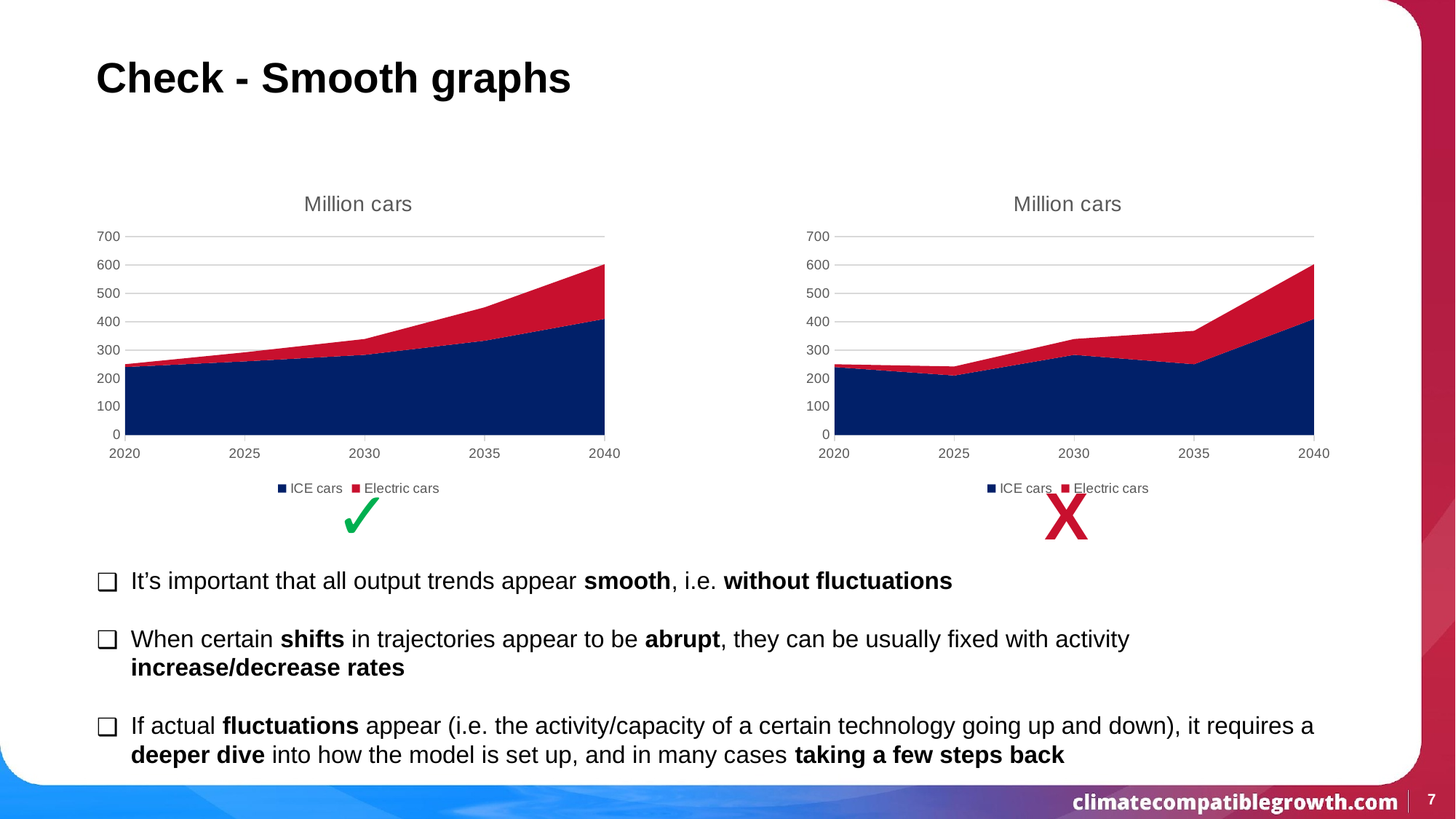
How many series does the legend of the left chart list? 2 What kind of chart is the left chart titled 'Million cars'? Area chart In the left chart, is the total value for 2040 greater or less than 500? greater In the right chart, is the value for ICE cars larger in 2030 or in 2035? 2030 In the right chart, is the value for ICE cars in 2025 greater or less than 300? less In the left chart, does the total number of cars rise or fall from 2020 to 2040? Rise In the right chart, which year has the lowest value for ICE cars? 2025 In the left chart, which year has the highest total number of cars? 2040 In the left chart, is the value for ICE cars in 2020 greater or less than 300? less What are the two series named in the legend of the right chart? ICE cars and Electric cars How many years are labelled on the x axis of the left chart? 5